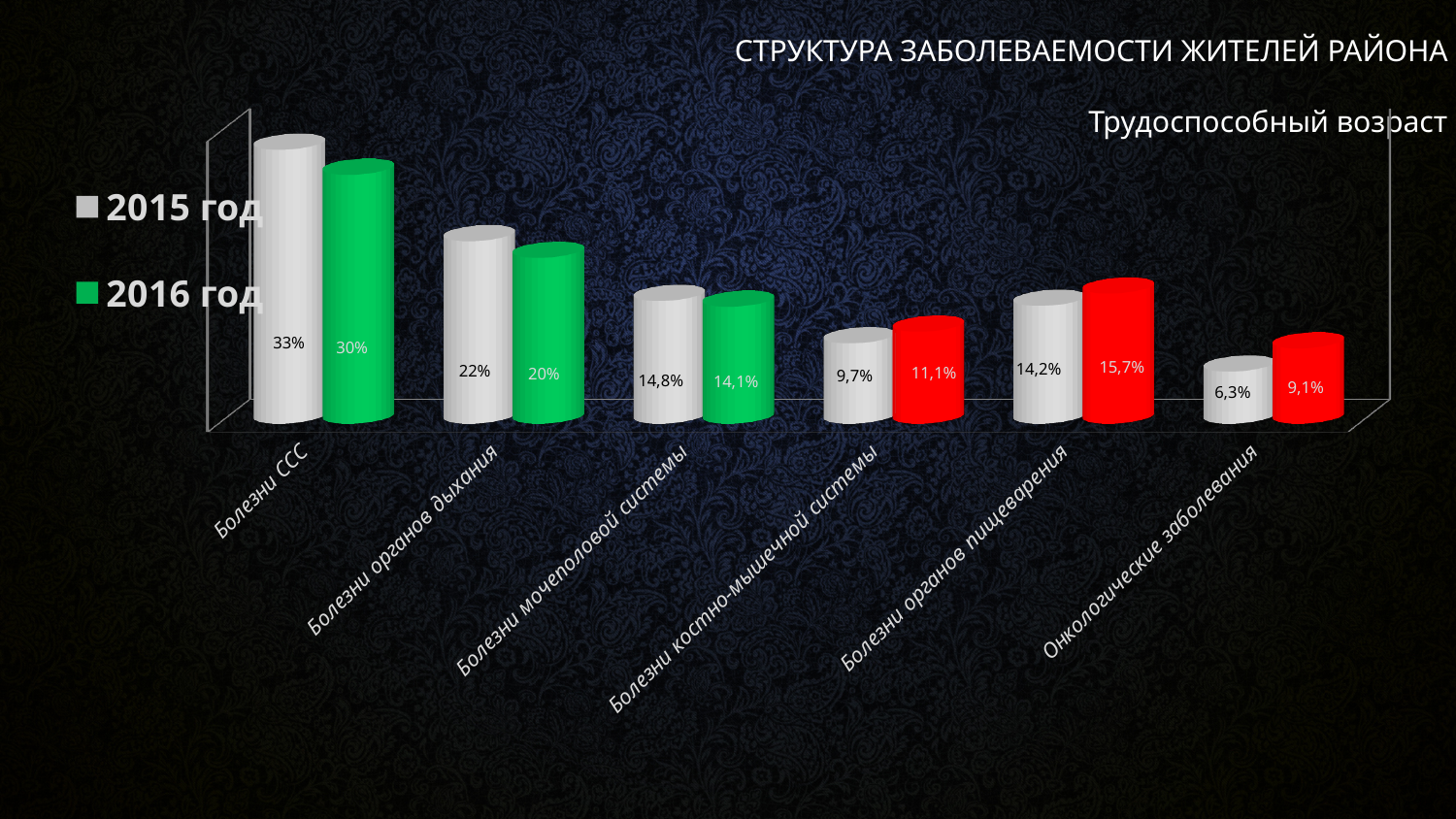
Which category has the highest 2016 год value? Болезни ССС What is the 2016 год value for Онкологические заболевания? 9,1% How many series does the legend list? 2 What is the difference between the 2016 год and 2015 год values for Онкологические заболевания? 2,8 percentage points Which category has the lowest 2015 год value? Онкологические заболевания Which is larger for Болезни костно-мышечной системы: the 2015 год value or the 2016 год value? 2016 год What is the 2016 год value for Болезни органов пищеварения? 15,7% How many categories are shown on the x axis? 6 What is the 2015 год value for Болезни ССС? 33% What kind of chart is shown on the slide? Bar chart What is the difference between the 2015 год and 2016 год values for Болезни ССС? 3 percentage points What is the 2015 год value for Болезни мочеполовой системы? 14,8%